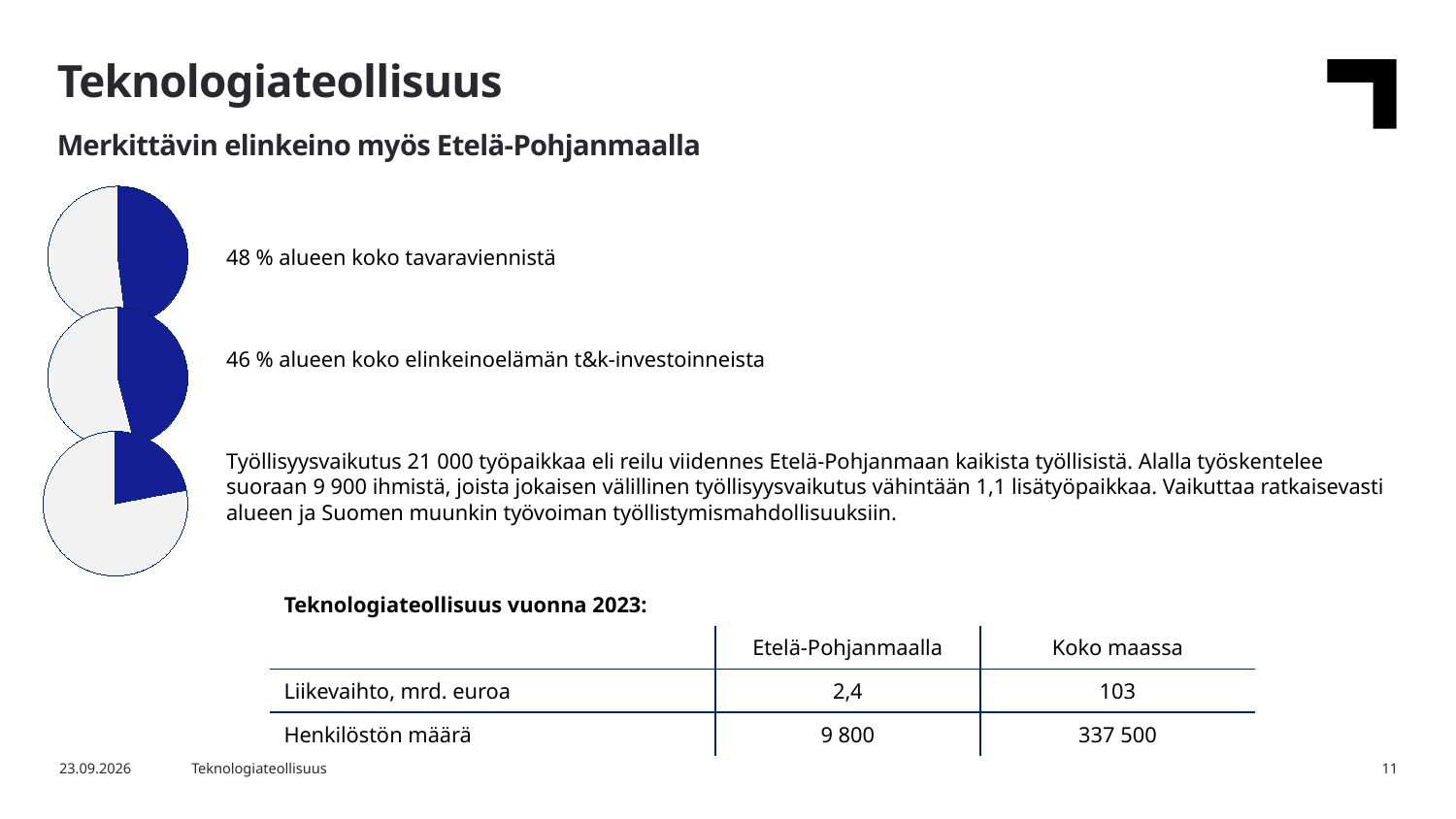
In the top pie chart (alueen koko tavaravienti), what share does the highlighted blue slice represent? 48 % Which of the three pie charts has the smallest highlighted slice? The bottom pie chart (työllisyysvaikutus) In the middle pie chart (alueen koko elinkeinoelämän t&k-investoinnit), what share does the highlighted blue slice represent? 46 % How many pie charts are shown on the slide? 3 What does the top pie chart's highlighted slice represent, according to the text next to it? 48 % alueen koko tavaraviennistä What colour is the highlighted slice in each pie chart? Blue Is the highlighted slice in the bottom pie chart (työllisyysvaikutus) larger or smaller than the highlighted slice in the top pie chart (tavaravienti)? Smaller What kind of chart is the top chart on the left of the slide? Pie chart Which has the larger highlighted share: the top pie chart (tavaravienti) or the middle pie chart (t&k-investoinnit)? Top pie chart (tavaravienti) Which of the three pie charts has the largest highlighted slice? The top pie chart (tavaravienti, 48 %)